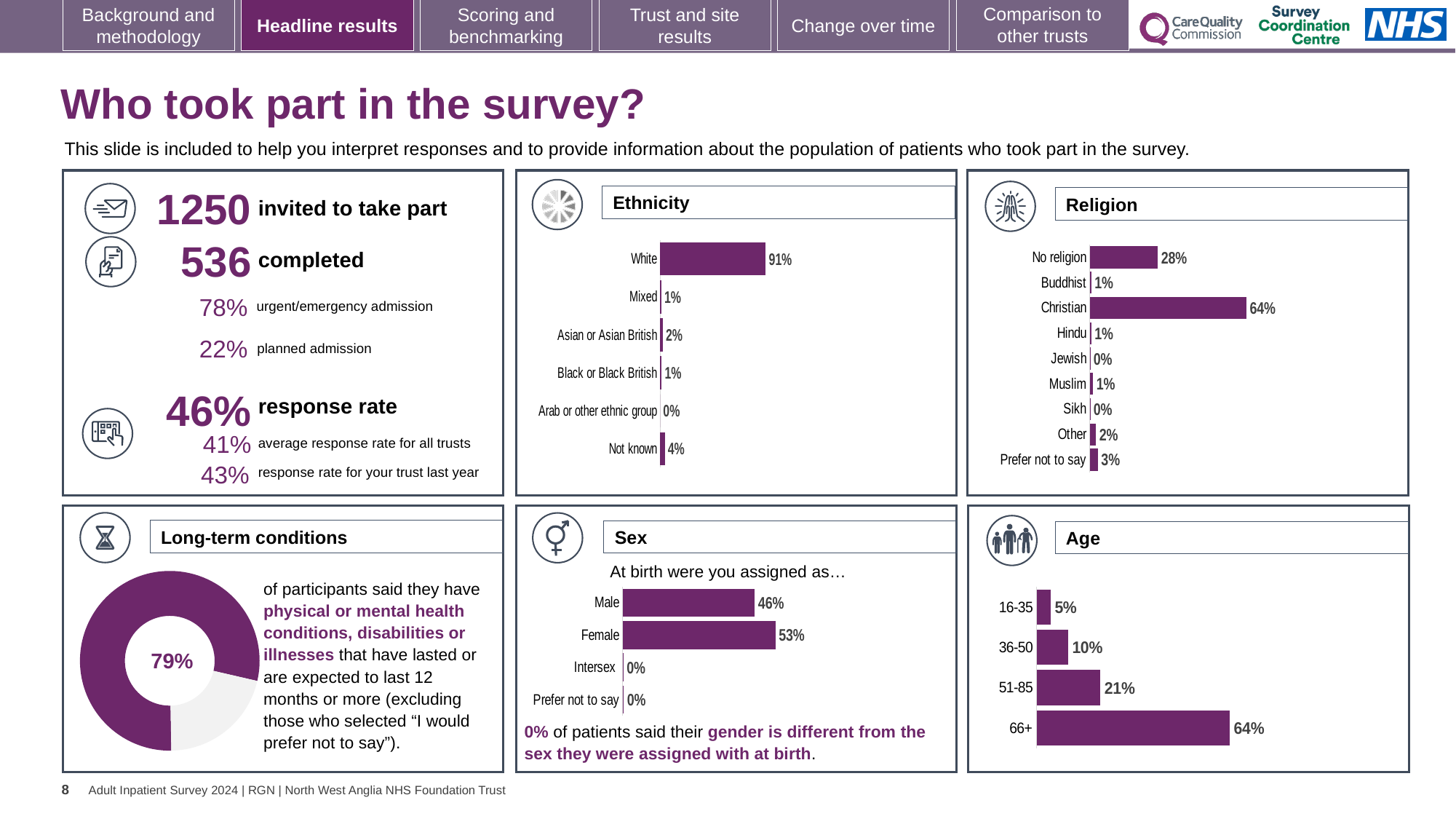
In the Religion chart, how many categories are shown? 9 In the Sex chart, which is larger, Male or Female? Female In the Long-term conditions chart, what share of participants said they have long-term conditions? 79% In the Age chart, what percentage of participants were aged 66+? 64% In the Age chart, do the values rise or fall as the age groups get older? rise In the Sex chart, what percentage of participants were Female? 53% In the Ethnicity chart, what percentage of participants were White? 91% In the Age chart, which age group has the lowest value? 16-35 In the Ethnicity chart, how many categories are shown? 6 In the Religion chart, what is the difference between the Christian and No religion values? 36% In the Religion chart, what percentage of participants were Christian? 64% In the Ethnicity chart, which category has the highest value? White